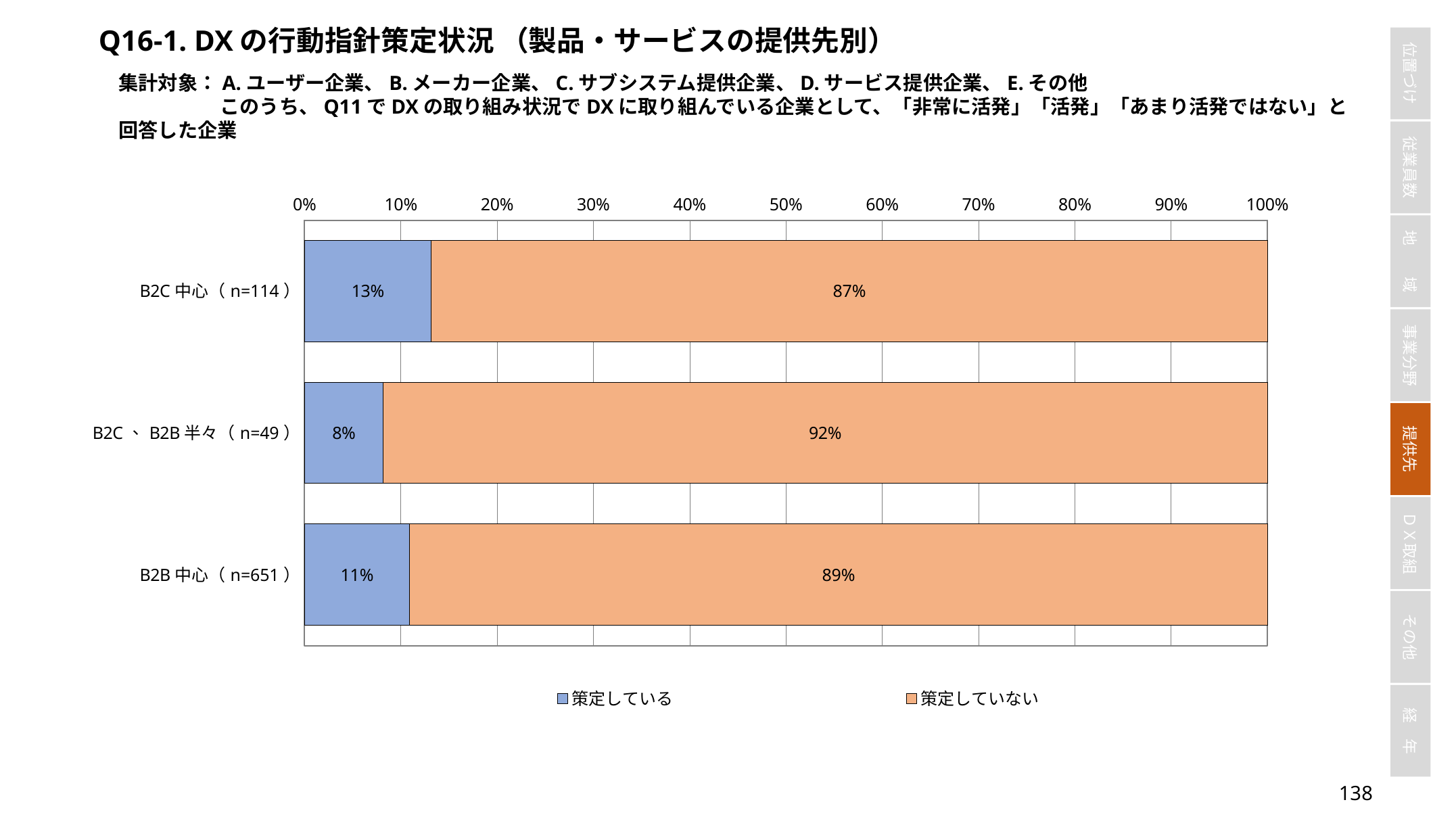
Which category has the lowest share of 策定している? B2C、B2B半々（n=49） How many series does the legend list? 2 What percentage of B2C中心（n=114） companies answered 策定している? 13% What is the difference in the 策定している share between B2C中心（n=114） and B2B中心（n=651）? 2 percentage points Is the 策定している value for B2C中心（n=114） greater or less than 10%? greater How many categories are shown on the chart? 3 What percentage of B2C、B2B半々（n=49） companies answered 策定していない? 92% Which has a larger 策定していない share, B2C、B2B半々（n=49） or B2B中心（n=651）? B2C、B2B半々（n=49） What percentage of B2B中心（n=651） companies answered 策定している? 11% What kind of chart is shown on the slide? Stacked bar chart Which category has the highest share of 策定している? B2C中心（n=114） What is the total of the stacked bar for B2B中心（n=651）? 100%